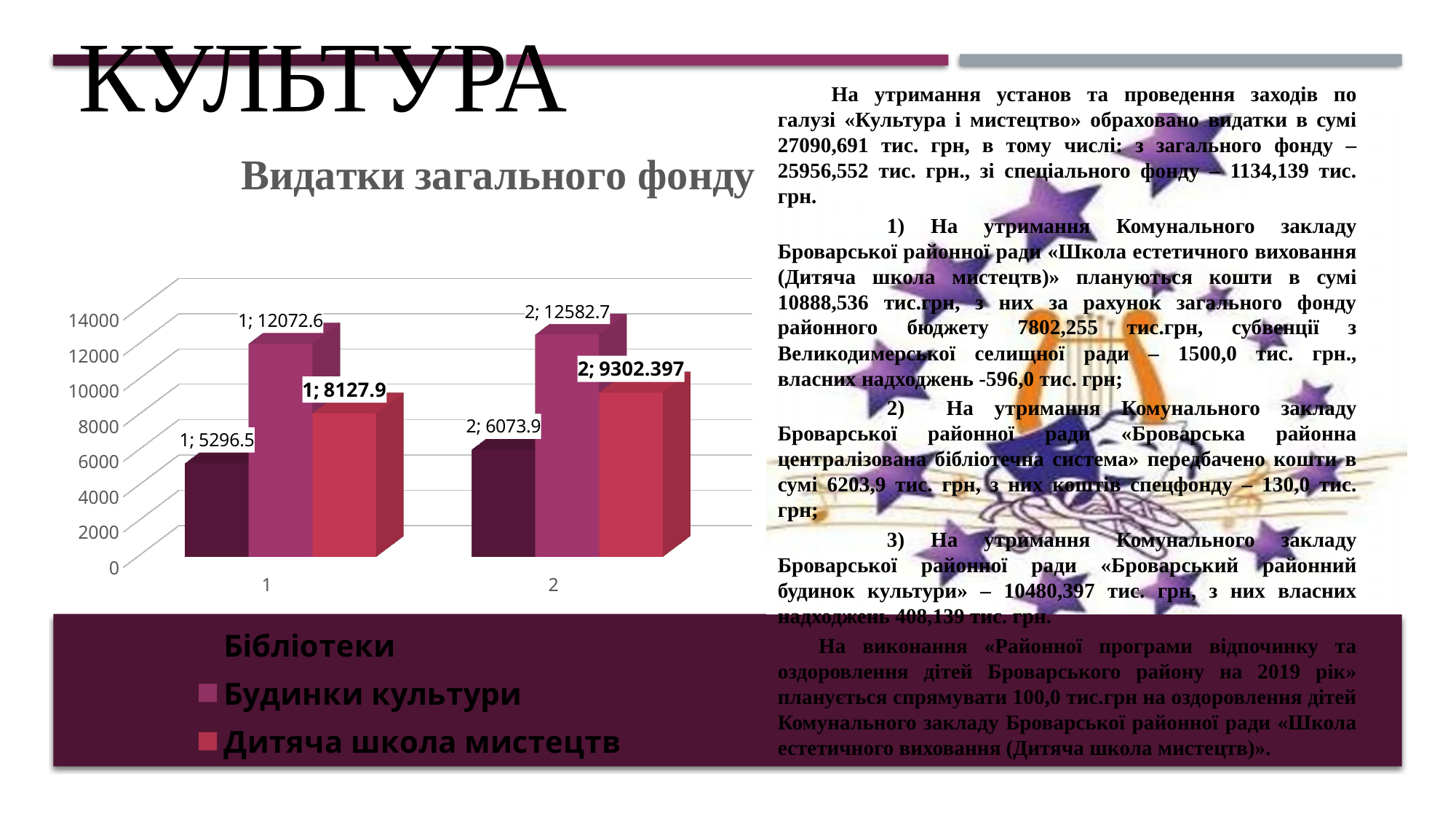
What is the difference between the Будинки культури values in category 2 and category 1? 510.1 Which series has the lowest value in category 2? Бібліотеки What is the value for Дитяча школа мистецтв in category 2? 9302.397 What is the value for Бібліотеки in category 1? 5296.5 What kind of chart is shown on the slide? bar chart What is the value for Дитяча школа мистецтв in category 1? 8127.9 What is the title of the chart? Видатки загального фонду Which series has the highest value in category 1? Будинки культури Is the value for Дитяча школа мистецтв in category 1 greater or less than 10000? less What is the value for Будинки культури in category 2? 12582.7 Which is larger: Бібліотеки in category 1 or Бібліотеки in category 2? Бібліотеки in category 2 How many series does the legend list? 3